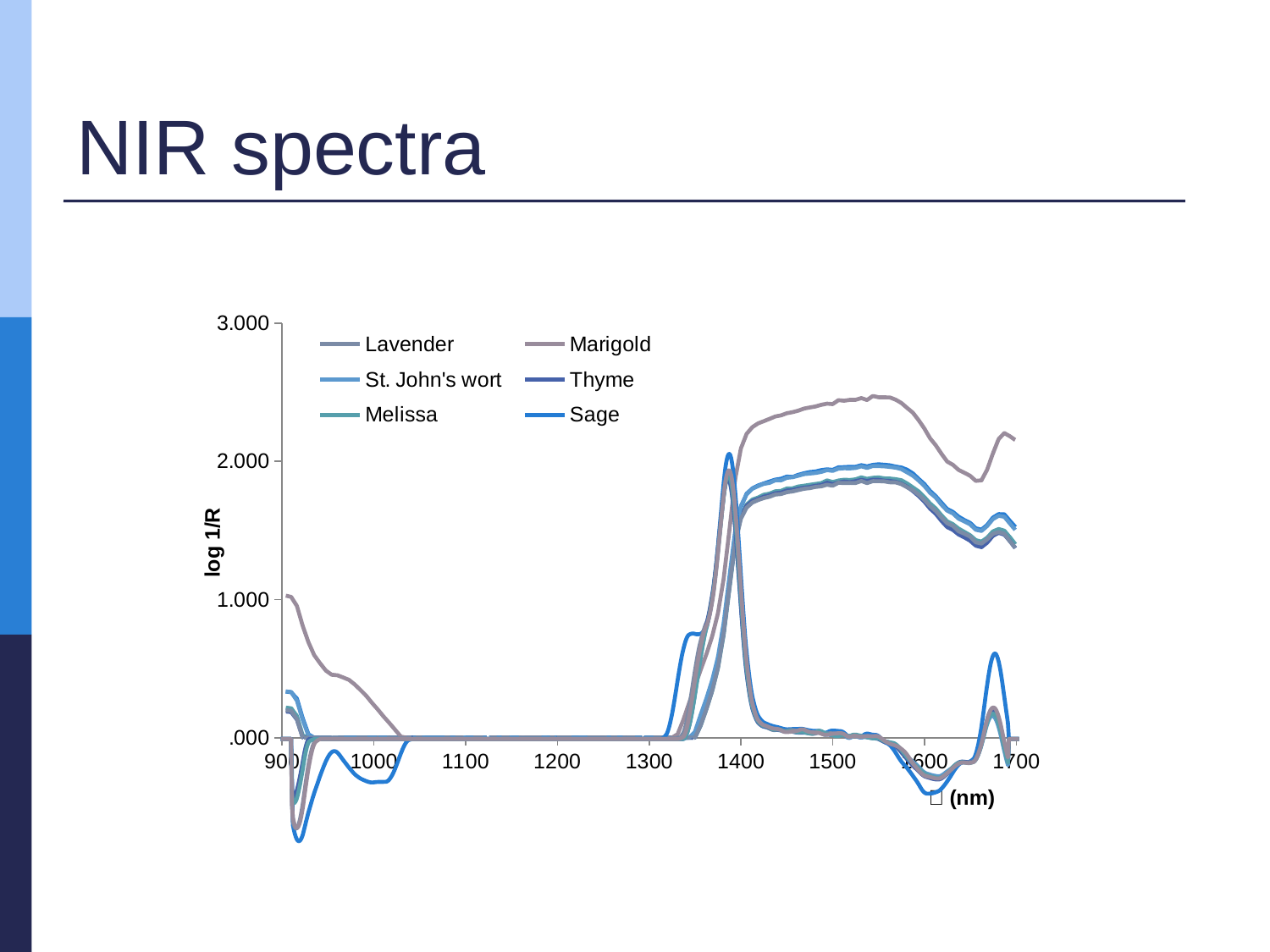
What kind of chart is shown on the slide? line chart Which series has the highest value at 1500 nm? Marigold What is the label of the y axis? log 1/R Which is larger at 1500 nm, the value for Marigold or the value for Thyme? Marigold What is the title of the slide containing the chart? NIR spectra What is the highest tick value shown on the y axis? 3.000 Is the value for Marigold at 1500 nm greater or less than 2.000? greater Is the value for Marigold at 900 nm greater or less than 2.000? less How many series does the legend list? 6 Does the Marigold line rise or fall between 900 nm and 1000 nm? fall